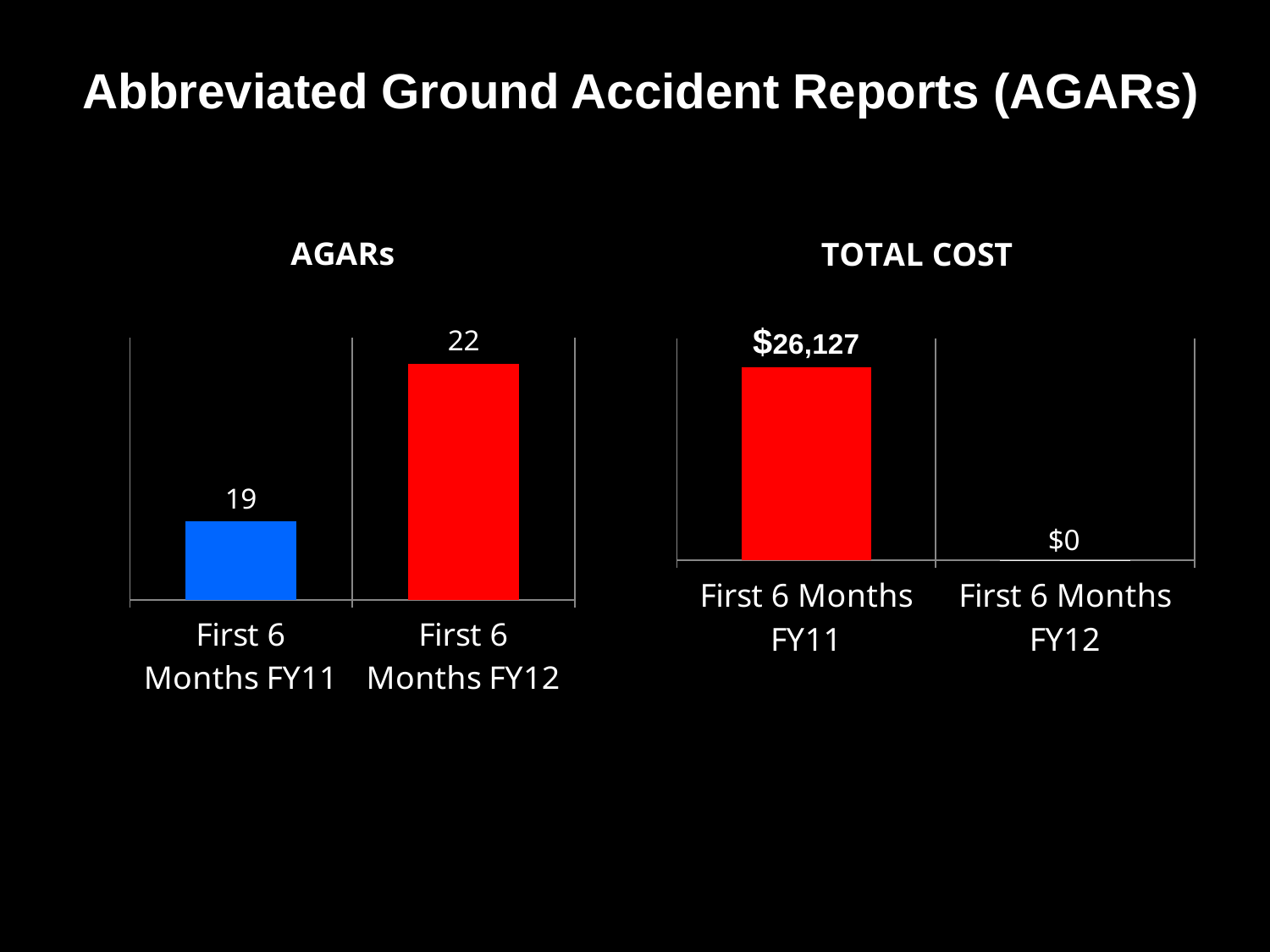
In the AGARs chart, which category has the highest value? First 6 Months FY12 In the TOTAL COST chart, which is larger: First 6 Months FY11 or First 6 Months FY12? First 6 Months FY11 In the TOTAL COST chart, what is the value for First 6 Months FY12? $0 In the AGARs chart, do the values rise or fall from First 6 Months FY11 to First 6 Months FY12? Rise What is the title of the chart on the right side of the slide? TOTAL COST In the AGARs chart, what is the value for First 6 Months FY11? 19 In the TOTAL COST chart, what is the value for First 6 Months FY11? $26,127 In the TOTAL COST chart, which category has the lowest value? First 6 Months FY12 How many categories does the AGARs chart show? 2 What kind of chart is the TOTAL COST chart? Bar chart In the AGARs chart, what is the difference between the First 6 Months FY12 and First 6 Months FY11 values? 3 In the AGARs chart, what is the value for First 6 Months FY12? 22